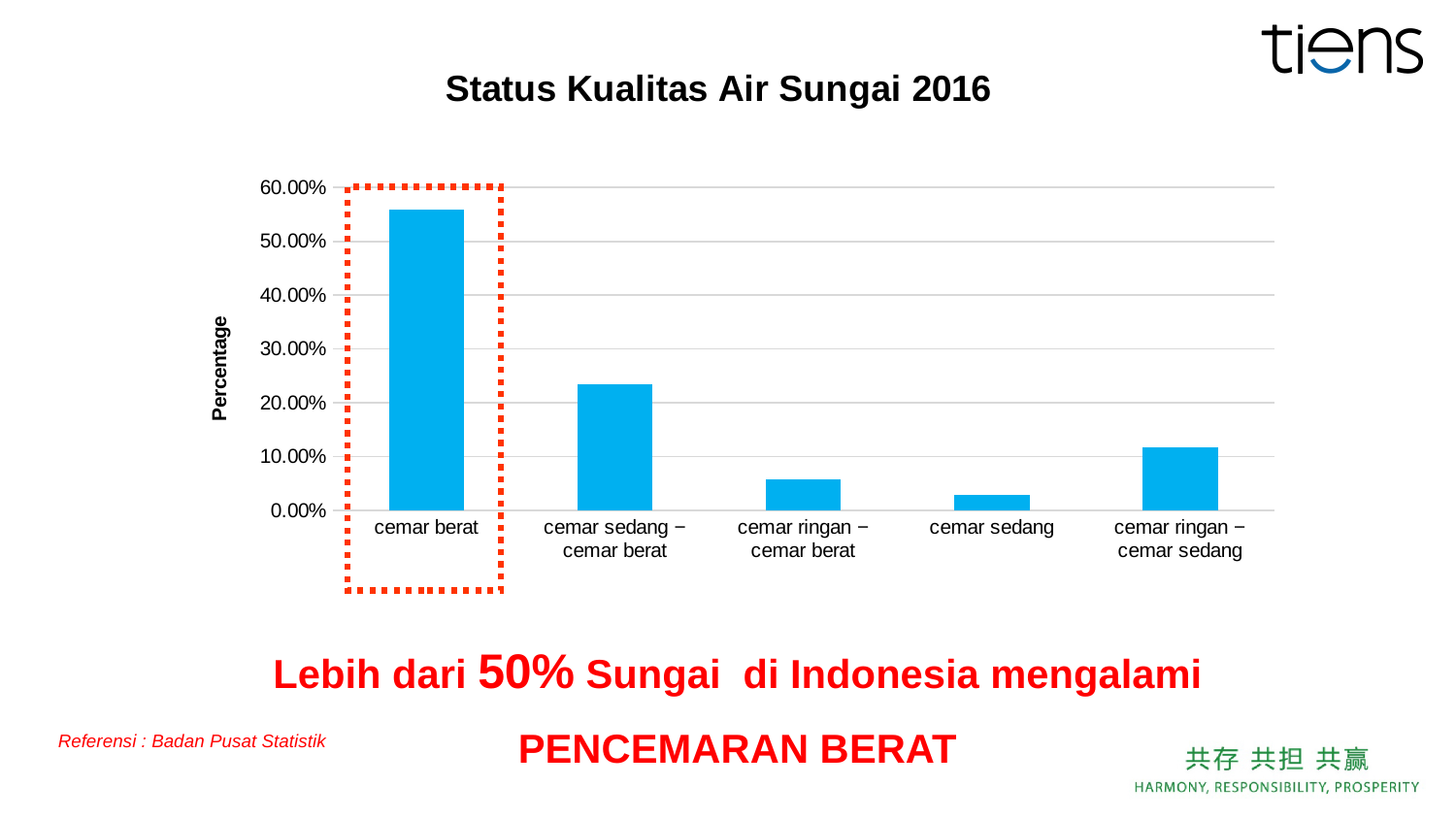
Is the value for cemar berat greater or less than 50.00%? greater Is the value for cemar ringan − cemar sedang greater or less than 10.00%? greater What is the title of the chart? Status Kualitas Air Sungai 2016 Which category has the lowest value? cemar sedang Is the value for cemar sedang − cemar berat greater or less than 20.00%? greater Which category has the highest value? cemar berat What type of chart is shown on the slide? bar chart What is the label of the vertical axis of the chart? Percentage How many categories are shown on the x axis of the chart? 5 Which is larger, the value for cemar ringan − cemar sedang or the value for cemar ringan − cemar berat? cemar ringan − cemar sedang